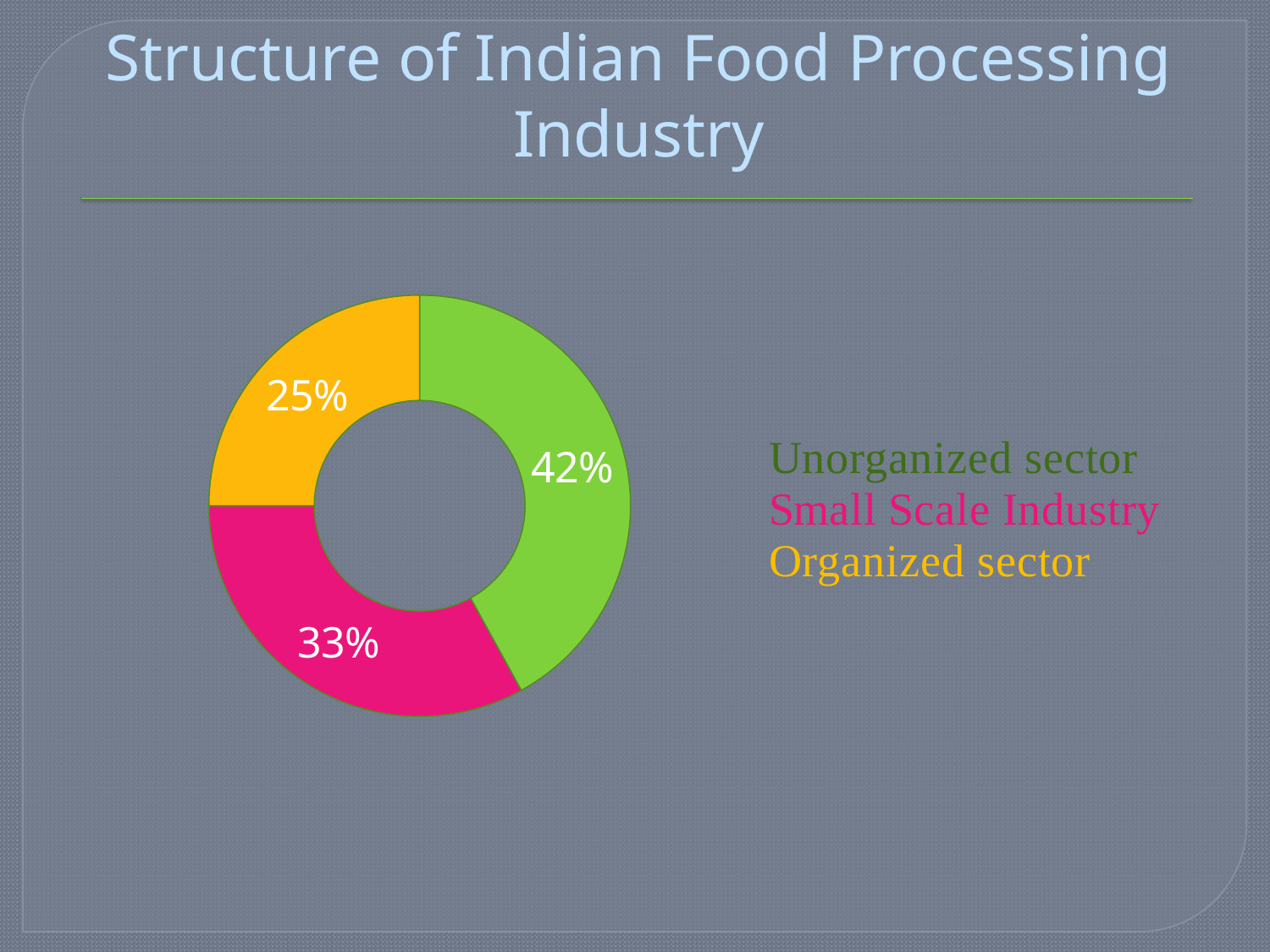
Which sector has the smallest share in the chart? Organized sector What colour represents Small Scale Industry in the chart? Pink What is the title of the slide containing the chart? Structure of Indian Food Processing Industry What is the difference in percentage points between Small Scale Industry and the Organized sector? 8 Which is larger, the share of Small Scale Industry or the share of the Organized sector? Small Scale Industry How many slices does the doughnut chart have? 3 What share of the doughnut chart does the Organized sector hold? 25% What share of the doughnut chart does Small Scale Industry hold? 33% What kind of chart is shown on the slide? Doughnut chart What share of the doughnut chart does the Unorganized sector hold? 42% What is the difference in percentage points between the Unorganized sector and the Organized sector? 17 Which sector has the largest share in the chart? Unorganized sector